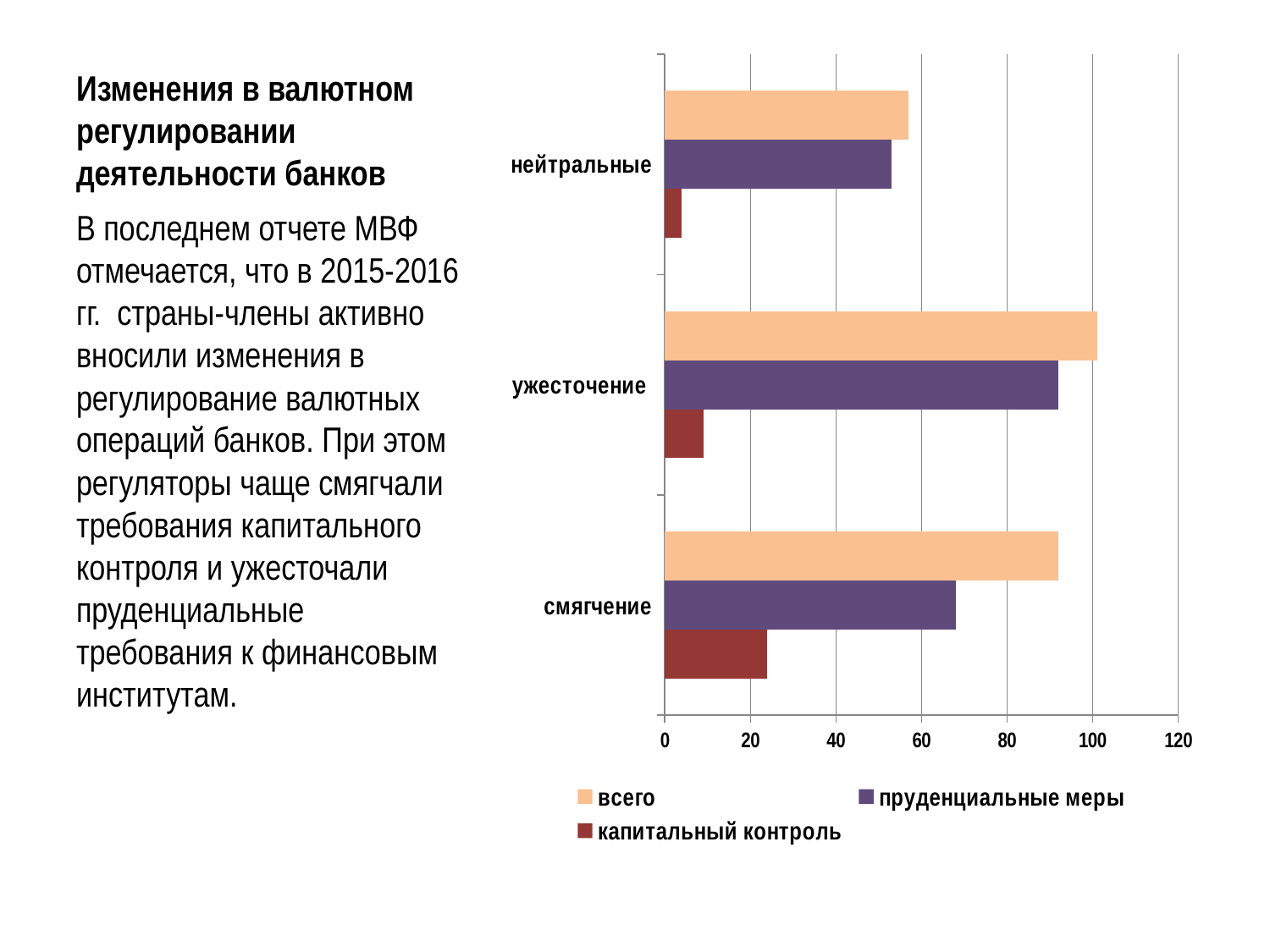
Which category has the lowest value for the series 'капитальный контроль'? нейтральные Is the value of 'всего' for 'нейтральные' greater or less than 40? greater How many series does the chart legend list? 3 Which series is shown in the dark red colour in the legend? капитальный контроль Which category has the highest value for the series 'всего'? ужесточение Which category has the highest value for the series 'капитальный контроль'? смягчение What kind of chart is shown on the slide? bar chart Is the value of 'пруденциальные меры' for 'нейтральные' greater or less than 60? less For the category 'смягчение', which is larger: 'всего' or 'пруденциальные меры'? всего Is the value of 'всего' for 'ужесточение' greater or less than 80? greater How many categories are shown on the vertical axis of the chart? 3